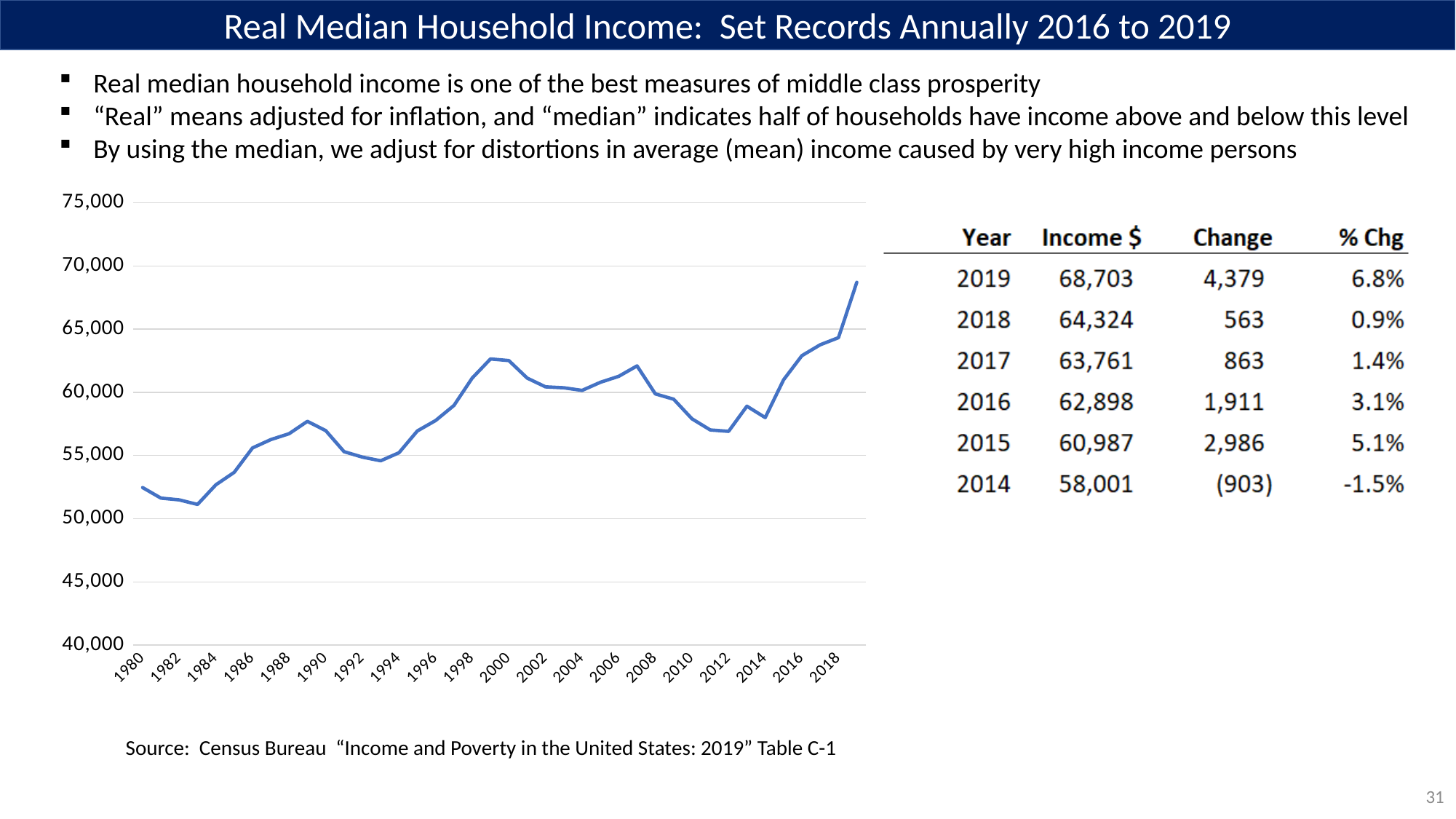
Is the value for 2000 greater or less than 60,000? greater Which year has the highest real median household income in the chart? 2019 According to the table, by how much did income change from 2018 to 2019? 4,379 What is the highest value shown on the chart's vertical axis? 75,000 Overall, does real median household income rise or fall from 1980 to 2019 in the chart? rise Is the value for 1980 greater or less than 55,000? less Is the value for 2012 greater or less than 60,000? less What kind of chart is shown on the slide? line chart Which year has the higher value, 2000 or 2010? 2000 According to the table next to the chart, what was real median household income in 2019? 68,703 According to the table next to the chart, what was the percent change in income in 2016? 3.1%